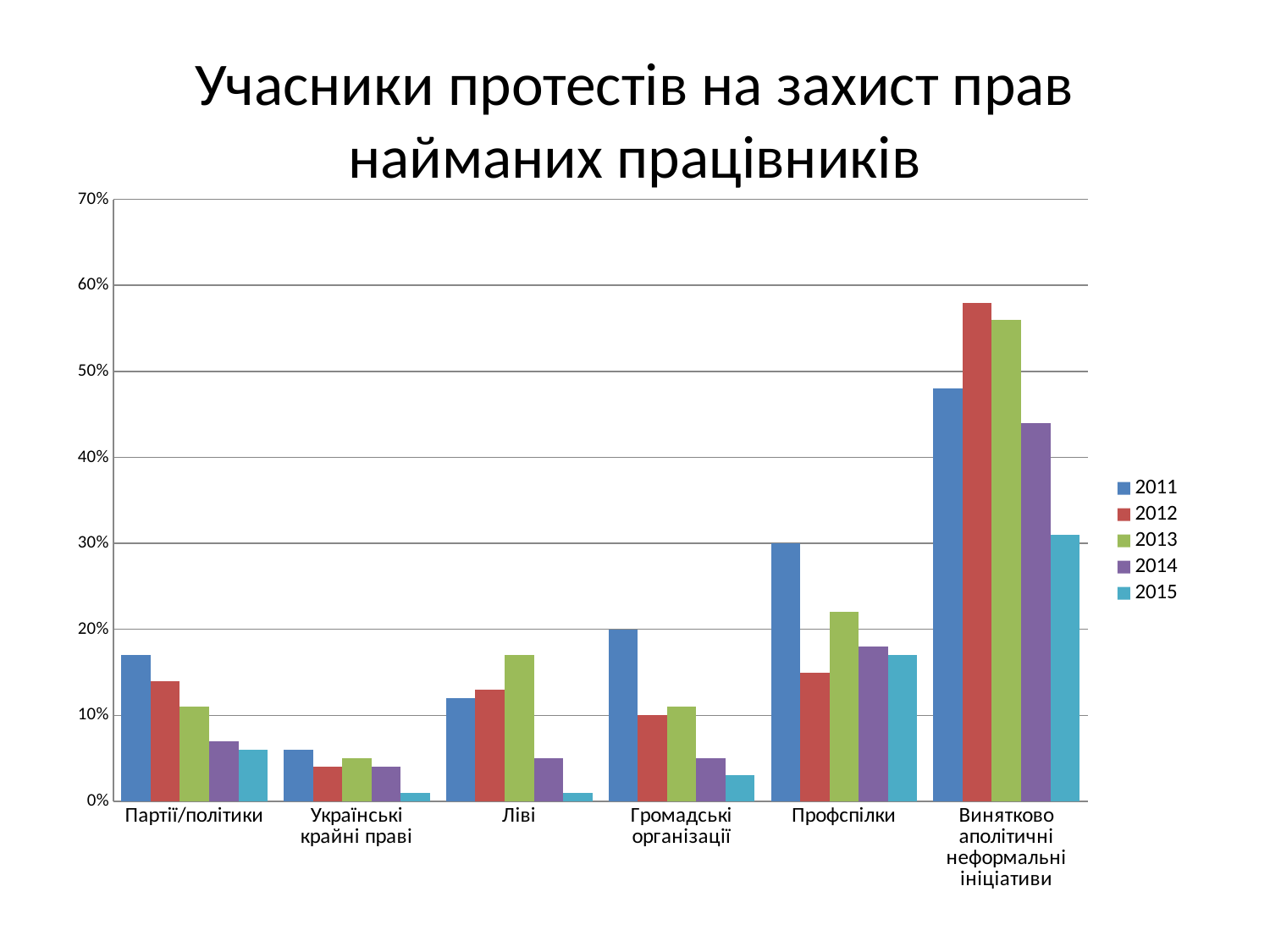
Which category has the lowest value for 2011? Українські крайні праві How many series does the legend list? 5 Which year is shown in the legend with the blue colour? 2011 Which category has the highest value for 2012? Винятково аполітичні неформальні ініціативи For Профспілки, which is larger: the 2011 value or the 2012 value? 2011 How many categories are shown on the x axis? 6 Is the 2012 value for Винятково аполітичні неформальні ініціативи greater or less than 50%? greater Is the 2013 value for Ліві greater or less than 10%? greater What kind of chart is shown on the slide? bar chart What is the title of the chart? Учасники протестів на захист прав найманих працівників Is the 2011 value for Українські крайні праві greater or less than 10%? less